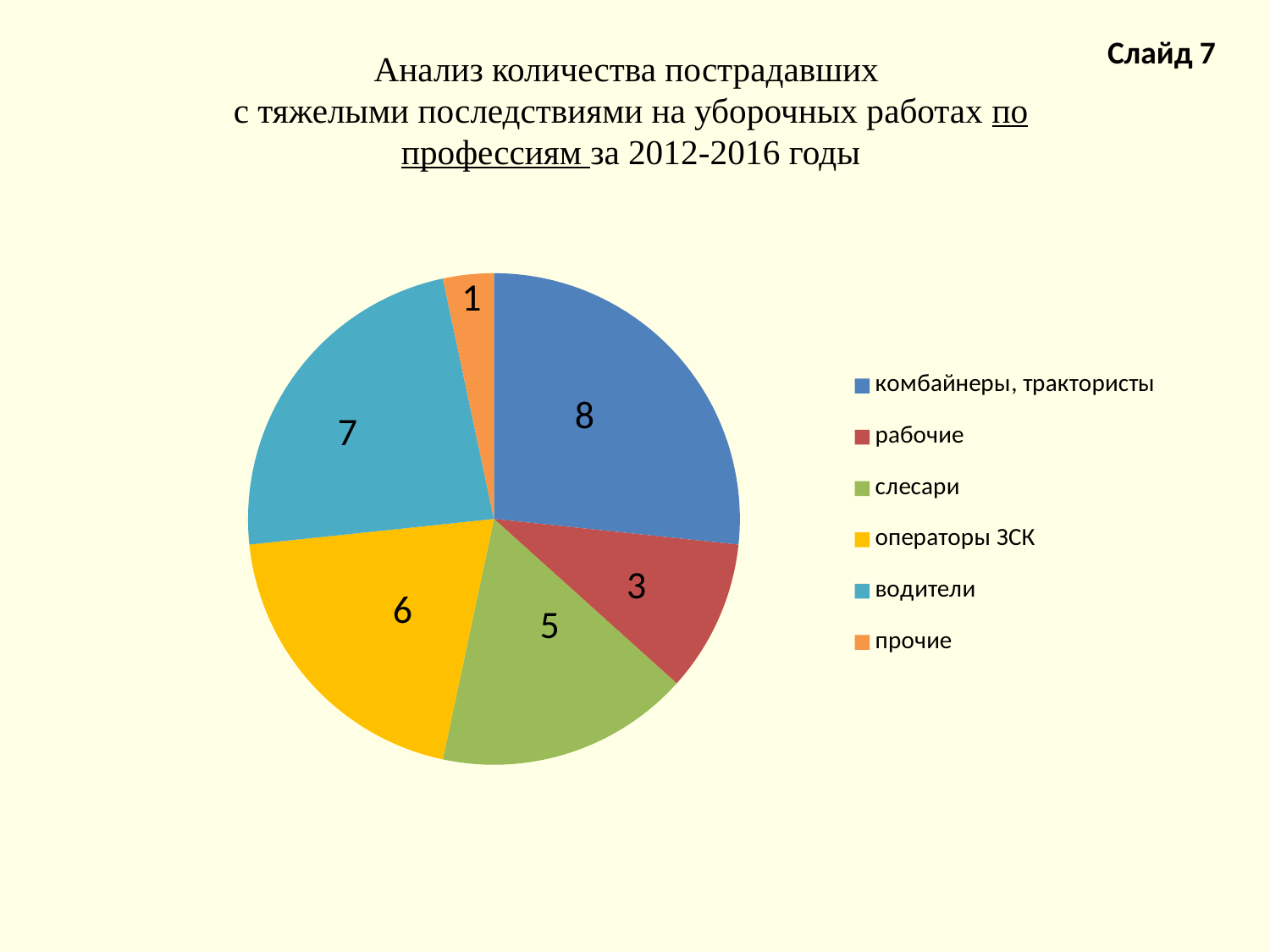
What is the difference between the values for комбайнеры, трактористы and рабочие? 5 Which profession has the largest slice of the pie? комбайнеры, трактористы What is the value for операторы ЗСК? 6 Which is larger, the value for слесари or the value for операторы ЗСК? операторы ЗСК What is the value for водители? 7 What is the value for прочие? 1 What colour is the slice for водители? light blue What type of chart is shown on the slide? pie chart How many slices does the pie chart have? 6 What share of the pie does the операторы ЗСК slice represent? 20% What is the value for комбайнеры, трактористы? 8 Which profession has the smallest slice of the pie? прочие